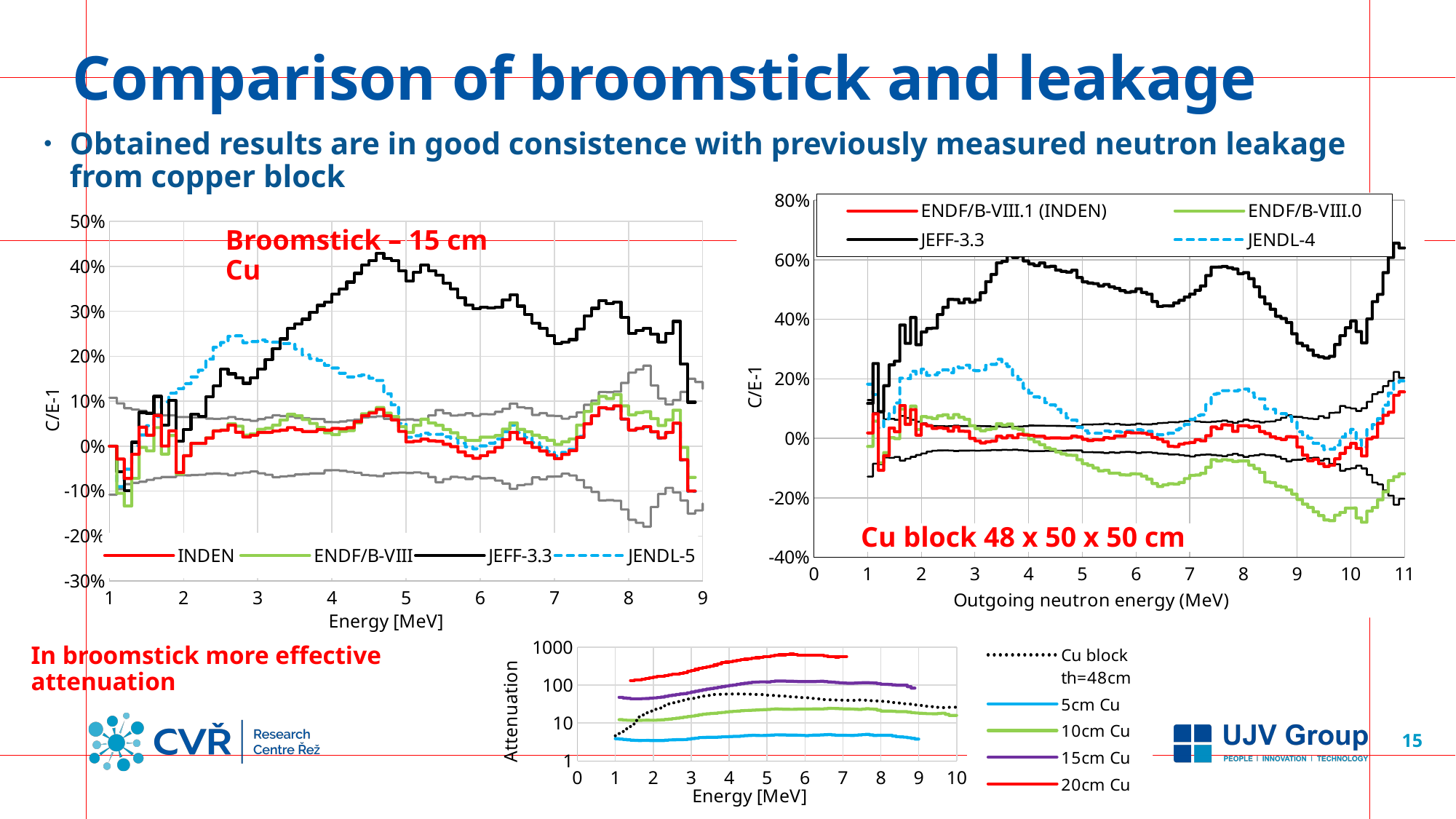
In the 'Cu block 48 x 50 x 50 cm' chart, is the ENDF/B-VIII.0 value near 9.5 MeV greater or less than -20%? less What is the x-axis label of the 'Cu block 48 x 50 x 50 cm' chart? Outgoing neutron energy (MeV) In the 'Cu block 48 x 50 x 50 cm' chart, which series is larger at 3.5 MeV, JEFF-3.3 or JENDL-4? JEFF-3.3 In the 'Cu block 48 x 50 x 50 cm' chart, is the peak value of JEFF-3.3 near 3.7 MeV greater or less than 50%? greater In the 'Broomstick – 15 cm Cu' chart, which series is larger at 4.5 MeV, JEFF-3.3 or INDEN? JEFF-3.3 What kind of chart is the 'Broomstick – 15 cm Cu' chart? line chart In the bottom Attenuation chart, is the attenuation for 5cm Cu at 5 MeV greater or less than 10? less In the bottom Attenuation chart, which series has the highest attenuation values? 20cm Cu How many series does the legend of the 'Cu block 48 x 50 x 50 cm' chart list? 4 How many series does the legend of the 'Broomstick – 15 cm Cu' chart list? 4